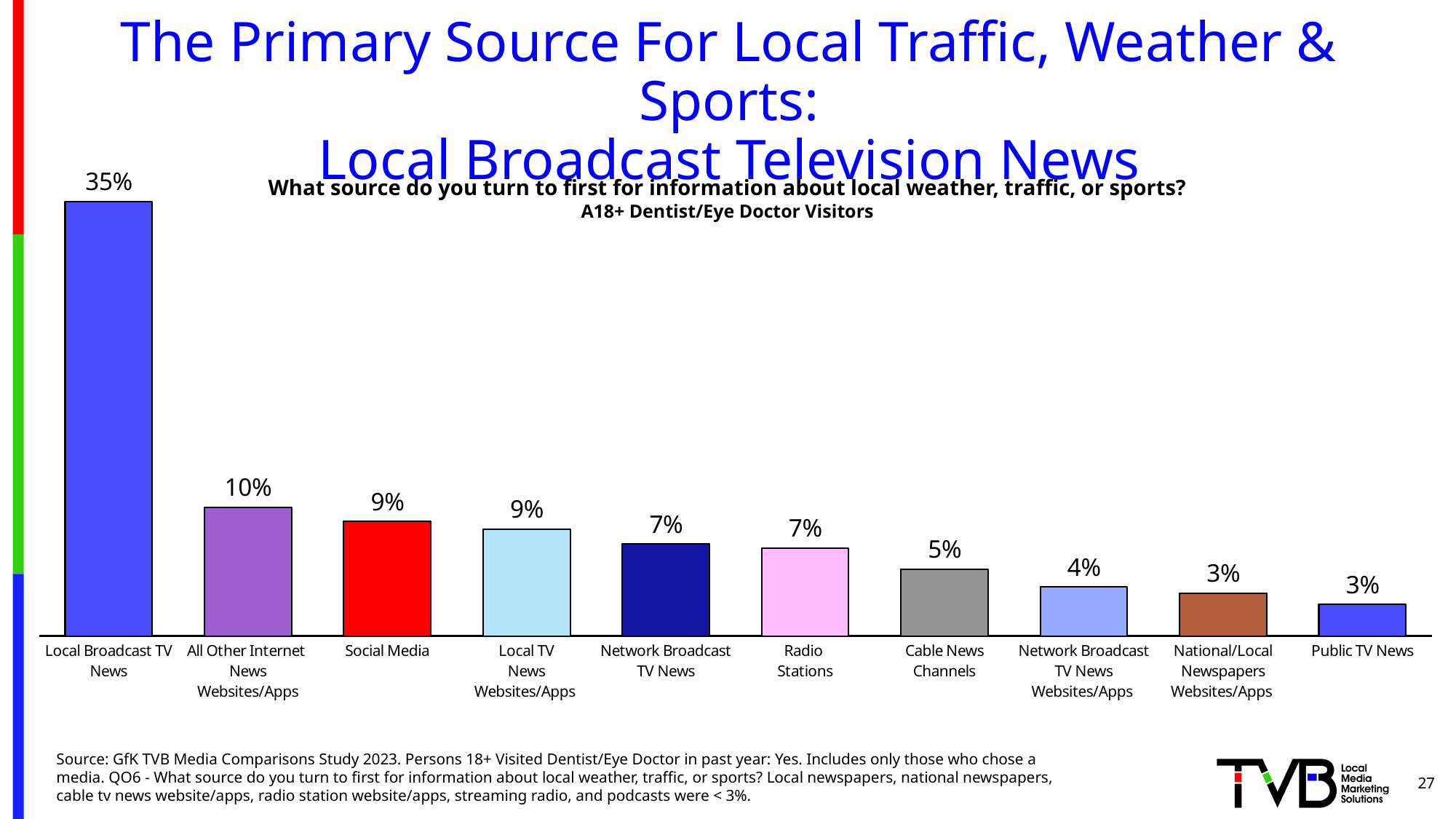
What colour is the bar for Social Media? Red Which is larger, the value for Radio Stations or the value for Network Broadcast TV News Websites/Apps? Radio Stations What is the value shown for All Other Internet News Websites/Apps? 10% What percentage of A18+ Dentist/Eye Doctor Visitors turn first to Local Broadcast TV News for local weather, traffic, or sports? 35% Which source has the highest value on the chart? Local Broadcast TV News What is the difference between the values for Social Media and Cable News Channels? 4% How many sources (bars) are shown on the chart? 10 What is the difference between the values for Local Broadcast TV News and All Other Internet News Websites/Apps? 25% What is the value shown for Cable News Channels? 5% What kind of chart is shown on the slide? Bar chart What value is shown for Public TV News? 3% Do the values generally rise or fall moving from left to right across the chart? Fall